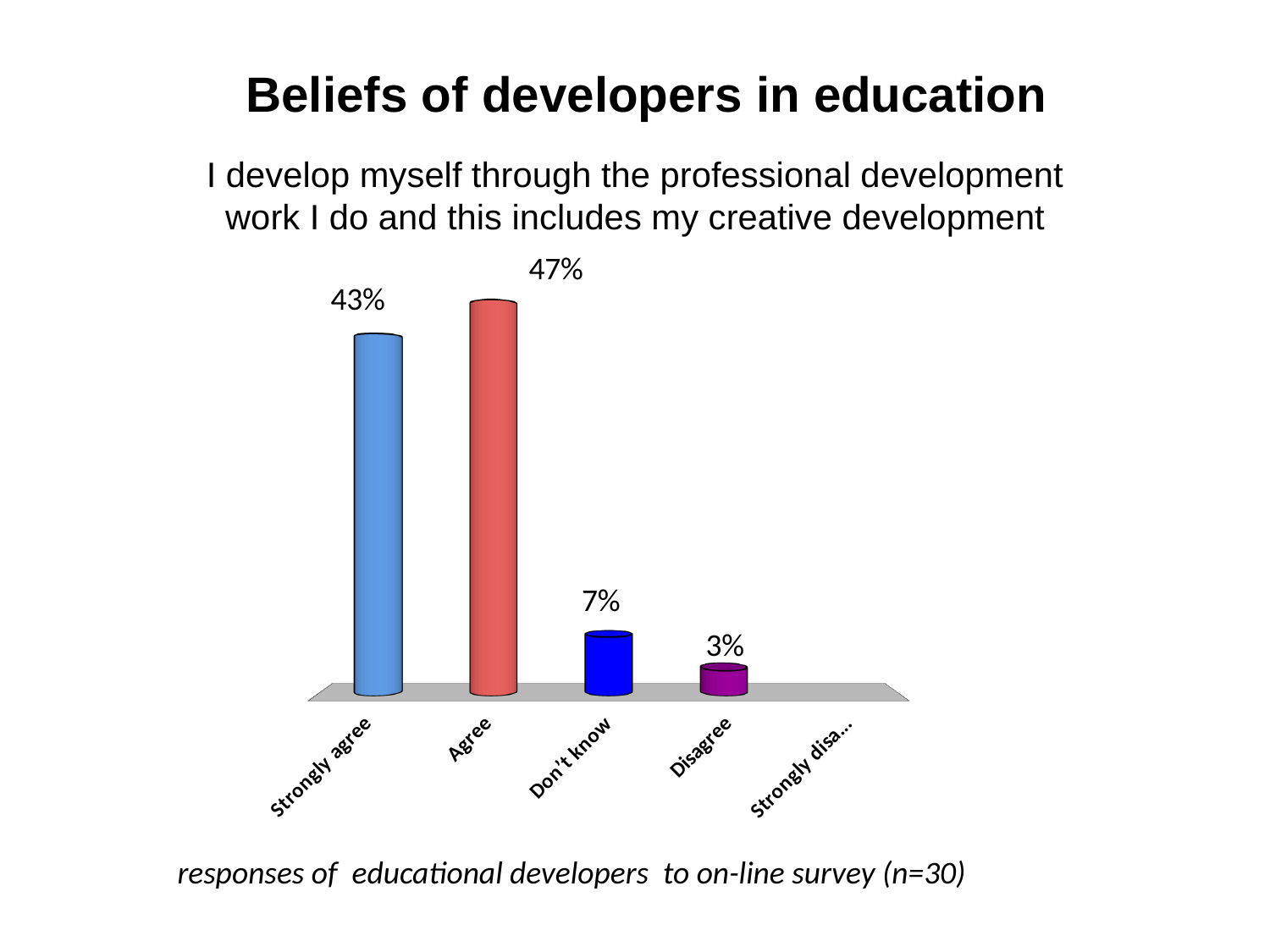
Which response category has the highest value? Agree What kind of chart is shown on the slide? Bar chart What percentage of respondents chose Strongly agree? 43% What is the value shown for Don't know? 7% What percentage of respondents chose Agree? 47% What is the value shown for Disagree? 3% What is the combined value of Strongly agree and Agree? 90% What is the difference between the Don't know and Disagree values? 4% What is the difference between the Agree and Strongly agree values? 4% What is the sample size stated in the caption below the chart? n=30 Which is larger, the value for Strongly agree or the value for Don't know? Strongly agree Among the categories with a labelled bar, which has the lowest value? Disagree